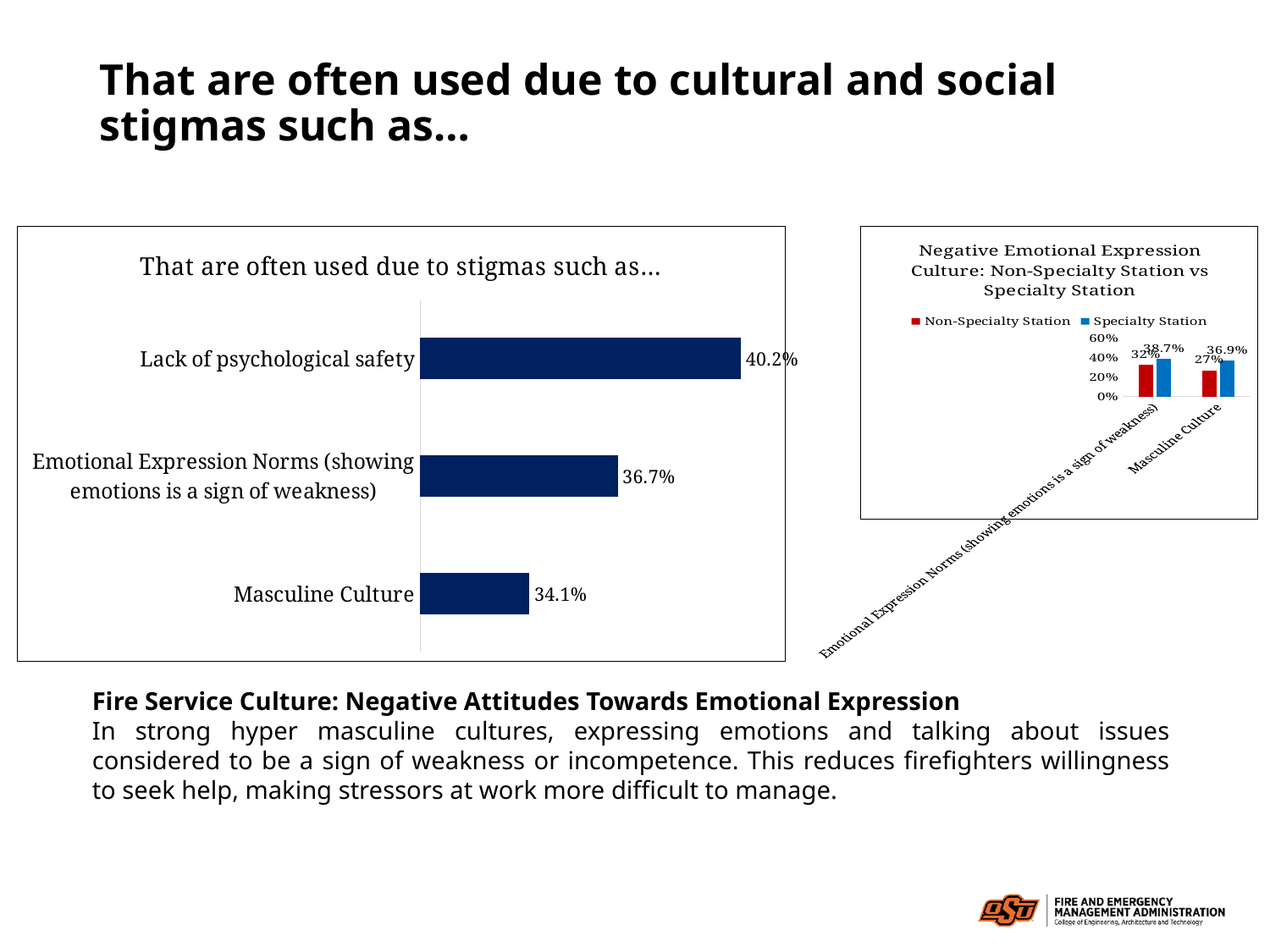
In the right chart titled 'Negative Emotional Expression Culture: Non-Specialty Station vs Specialty Station', which is larger for Masculine Culture: Non-Specialty Station or Specialty Station? Specialty Station In the right chart titled 'Negative Emotional Expression Culture: Non-Specialty Station vs Specialty Station', what is the Specialty Station value for Masculine Culture? 36.9% In the right chart titled 'Negative Emotional Expression Culture: Non-Specialty Station vs Specialty Station', what is the Non-Specialty Station value for Masculine Culture? 27% In the left chart titled 'That are often used due to stigmas such as...', what is the value for Masculine Culture? 34.1% In the left chart titled 'That are often used due to stigmas such as...', which category has the lowest value? Masculine Culture In the left chart titled 'That are often used due to stigmas such as...', how many categories are shown? 3 In the right chart titled 'Negative Emotional Expression Culture: Non-Specialty Station vs Specialty Station', what colour represents the Specialty Station series? Blue In the left chart titled 'That are often used due to stigmas such as...', what is the difference between Lack of psychological safety and Masculine Culture? 6.1% In the left chart titled 'That are often used due to stigmas such as...', what is the value for Lack of psychological safety? 40.2% What type of chart is the left chart titled 'That are often used due to stigmas such as...'? Bar chart In the right chart titled 'Negative Emotional Expression Culture: Non-Specialty Station vs Specialty Station', how many series does the legend list? 2 In the left chart titled 'That are often used due to stigmas such as...', which category has the highest value? Lack of psychological safety